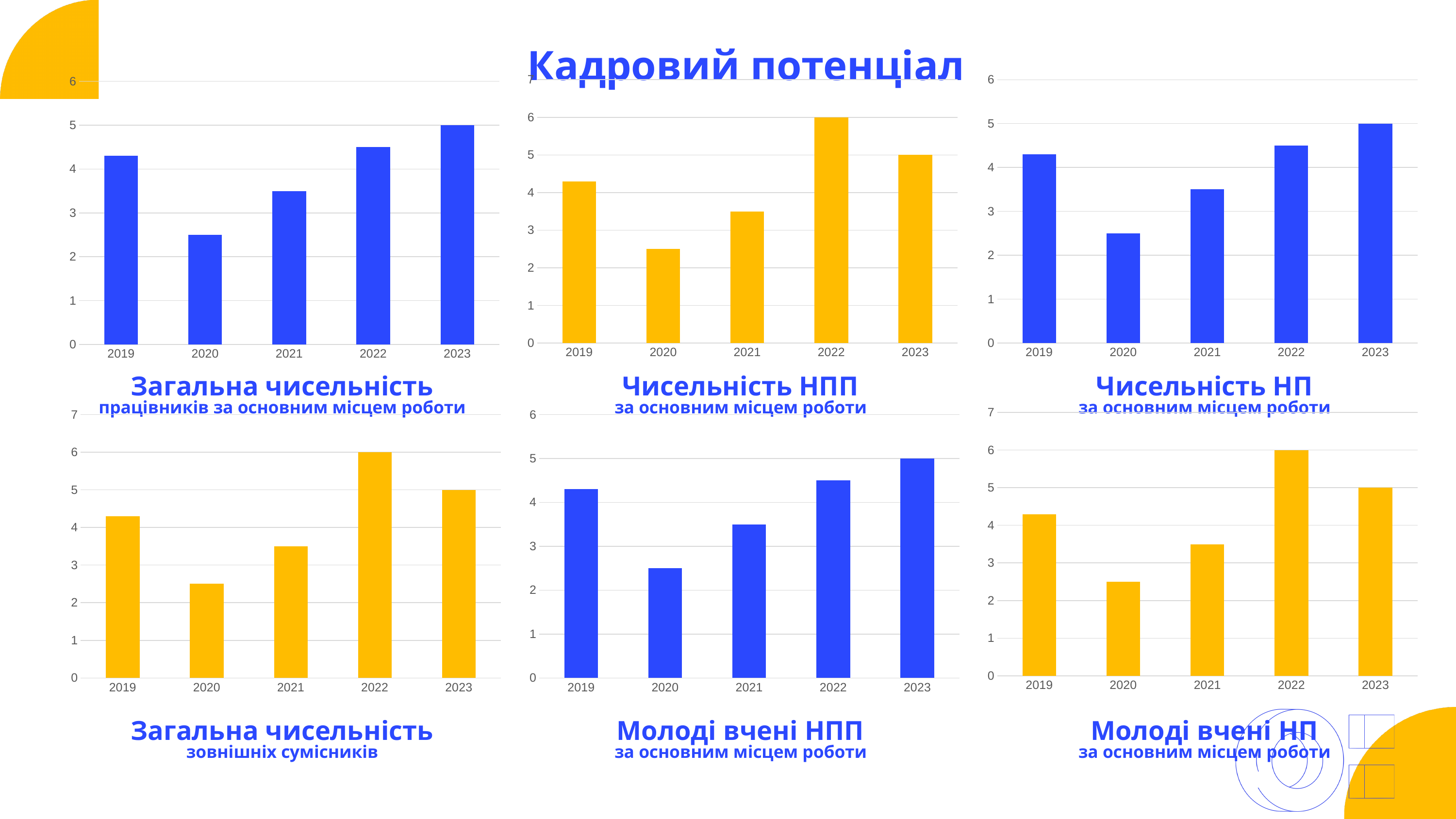
In the chart titled 'Загальна чисельність зовнішніх сумісників' (bottom left), what is the difference between the values for 2022 and 2023? 1 In the chart titled 'Загальна чисельність зовнішніх сумісників' (bottom left), what is the value for 2022? 6 What colour are the bars in the chart titled 'Чисельність НПП за основним місцем роботи' (top middle)? yellow In the chart titled 'Молоді вчені НПП за основним місцем роботи' (bottom middle), which is larger, the value for 2021 or the value for 2022? 2022 What type of chart is the one titled 'Молоді вчені НП за основним місцем роботи' (bottom right)? bar chart In the chart titled 'Молоді вчені НПП за основним місцем роботи' (bottom middle), what is the value for 2023? 5 In the chart titled 'Чисельність НПП за основним місцем роботи' (top middle), which year has the highest bar? 2022 In the chart titled 'Загальна чисельність працівників за основним місцем роботи' (top left), which year has the lowest bar? 2020 In the chart titled 'Молоді вчені НП за основним місцем роботи' (bottom right), what is the value for 2023? 5 In the chart titled 'Чисельність НП за основним місцем роботи' (top right), is the value for 2020 greater or less than 3? less In the chart titled 'Загальна чисельність працівників за основним місцем роботи' (top left), is the value for 2019 greater or less than 4? greater How many years are shown on the x axis of the chart titled 'Чисельність НП за основним місцем роботи' (top right)? 5